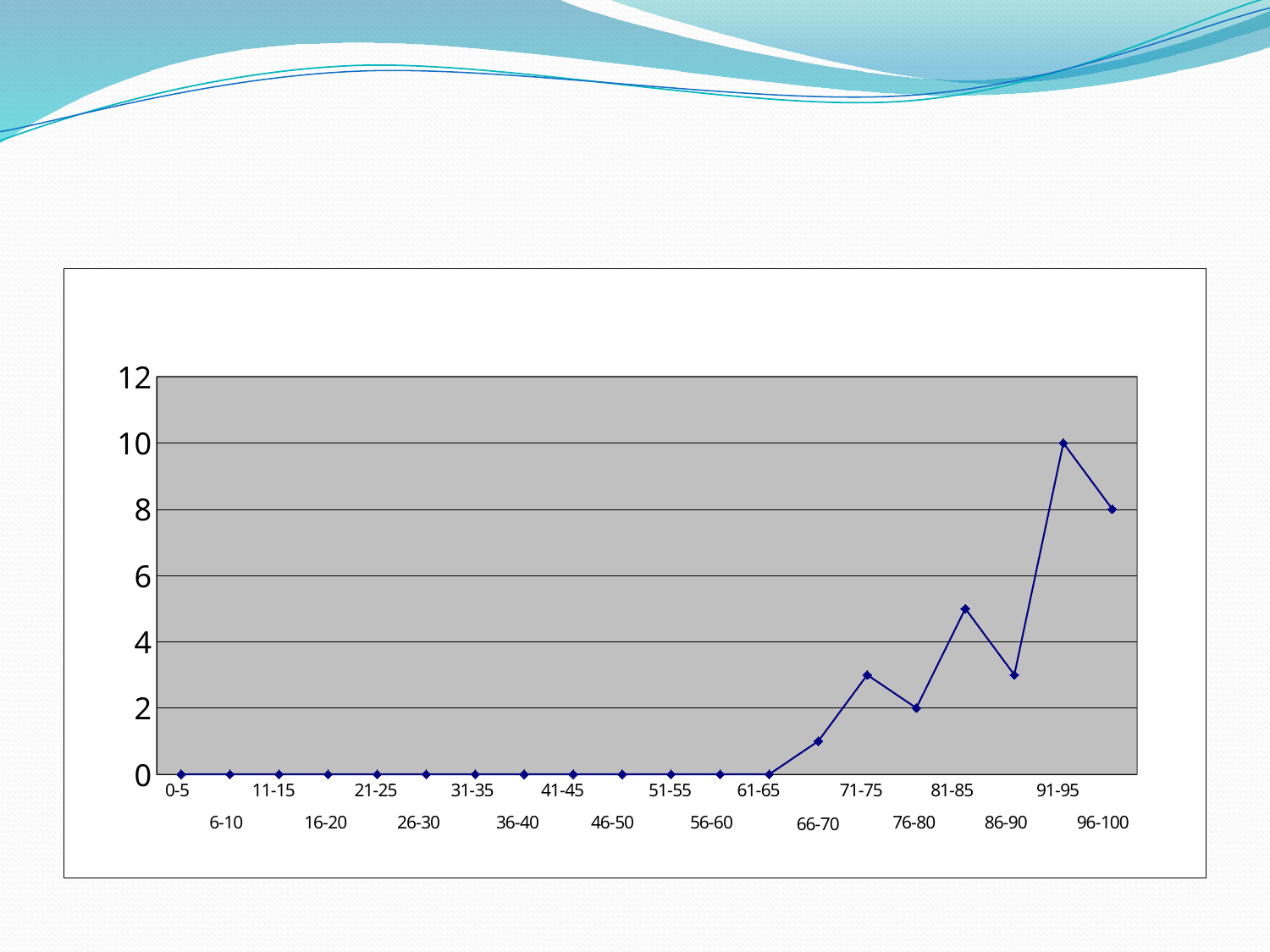
How many categories are plotted along the x axis? 20 Do the values generally rise or fall moving from left to right along the x axis? rise What is the value for the 96-100 category? 8 Is the value for 81-85 greater or less than 4? greater What is the difference between the values for 91-95 and 96-100? 2 What is the value for the 76-80 category? 2 What kind of chart is shown on the slide? line chart Is the value for 66-70 greater or less than 2? less What is the value for the 91-95 category? 10 Which category has the highest value? 91-95 What is the value for the 0-5 category? 0 Which is larger, the value for 81-85 or the value for 86-90? 81-85